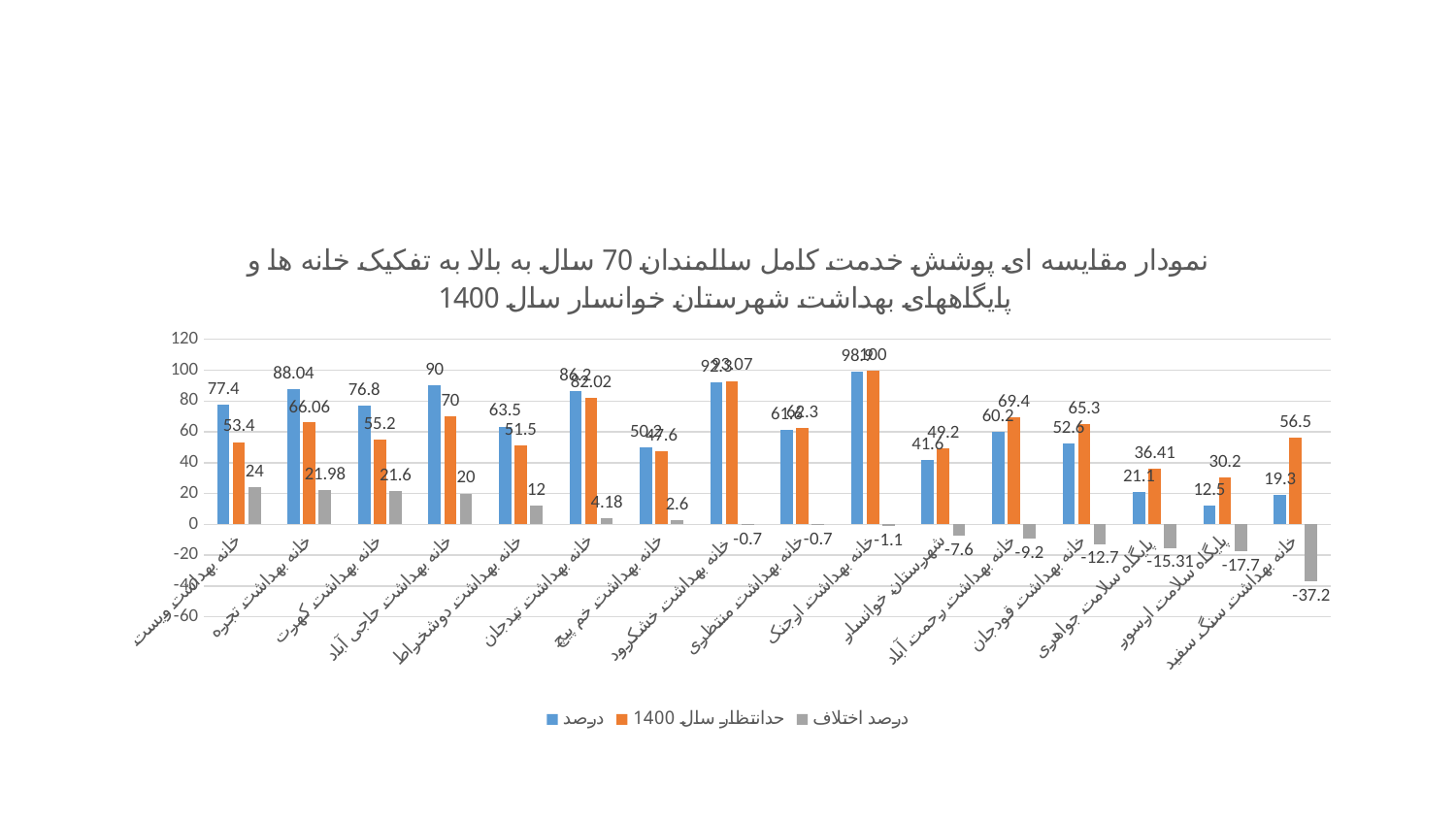
Which category has the highest value in the درصد اختلاف series? خانه بهداشت ویست How many series does the legend list? 3 What is the value of the حدانتظار سال 1400 series for خانه بهداشت سنگ سفید? 56.5 Which category has the lowest value in the درصد series? پایگاه سلامت ارسور What is the value of the درصد اختلاف series for پایگاه سلامت جواهری? -15.31 What type of chart is shown on the slide? bar chart Which category has the lowest value in the درصد اختلاف series? خانه بهداشت سنگ سفید What is the value of the درصد series for شهرستان خوانسار? 41.6 What is the value of the درصد series for خانه بهداشت حاجی آباد? 90 What is the difference between the درصد value and the حدانتظار سال 1400 value for خانه بهداشت ویست? 24 For خانه بهداشت حاجی آباد, which is larger: the درصد value or the حدانتظار سال 1400 value? درصد How many categories are shown on the x axis? 16